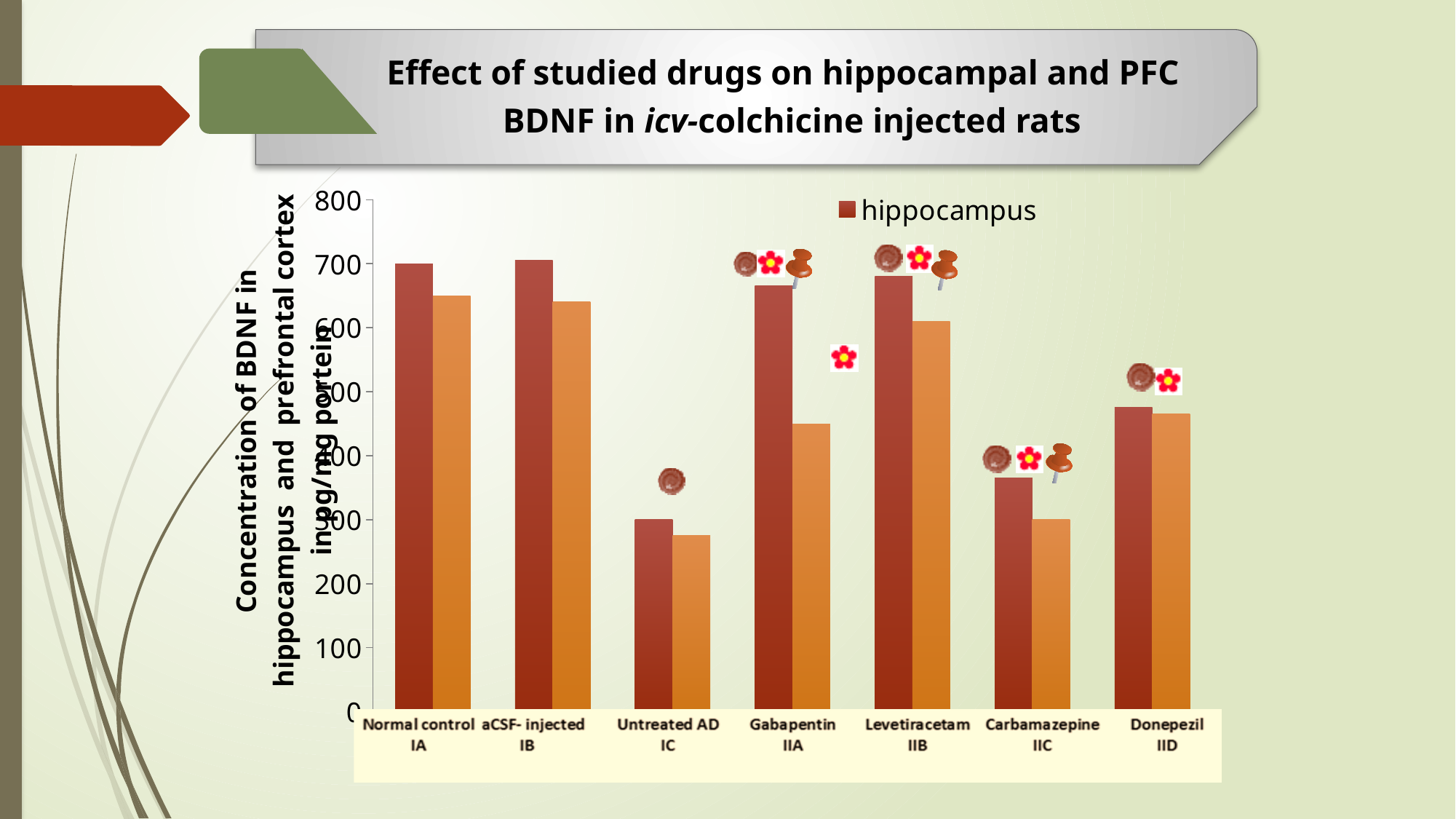
Which has the higher hippocampus value, Untreated AD IC or Donepezil IID? Donepezil IID Is the hippocampus value for Normal control IA greater or less than 600? greater What colour are the bars for the hippocampus series? dark red Which has the higher hippocampus value, Gabapentin IIA or Donepezil IID? Gabapentin IIA Which has the higher hippocampus value, Levetiracetam IIB or Carbamazepine IIC? Levetiracetam IIB Is the hippocampus value for Donepezil IID greater or less than 400? greater Is the hippocampus value for Carbamazepine IIC greater or less than 400? less How many treatment groups (categories) are shown on the x axis? 7 What kind of chart is shown on the slide? bar chart Which group has the lowest hippocampus BDNF value? Untreated AD IC